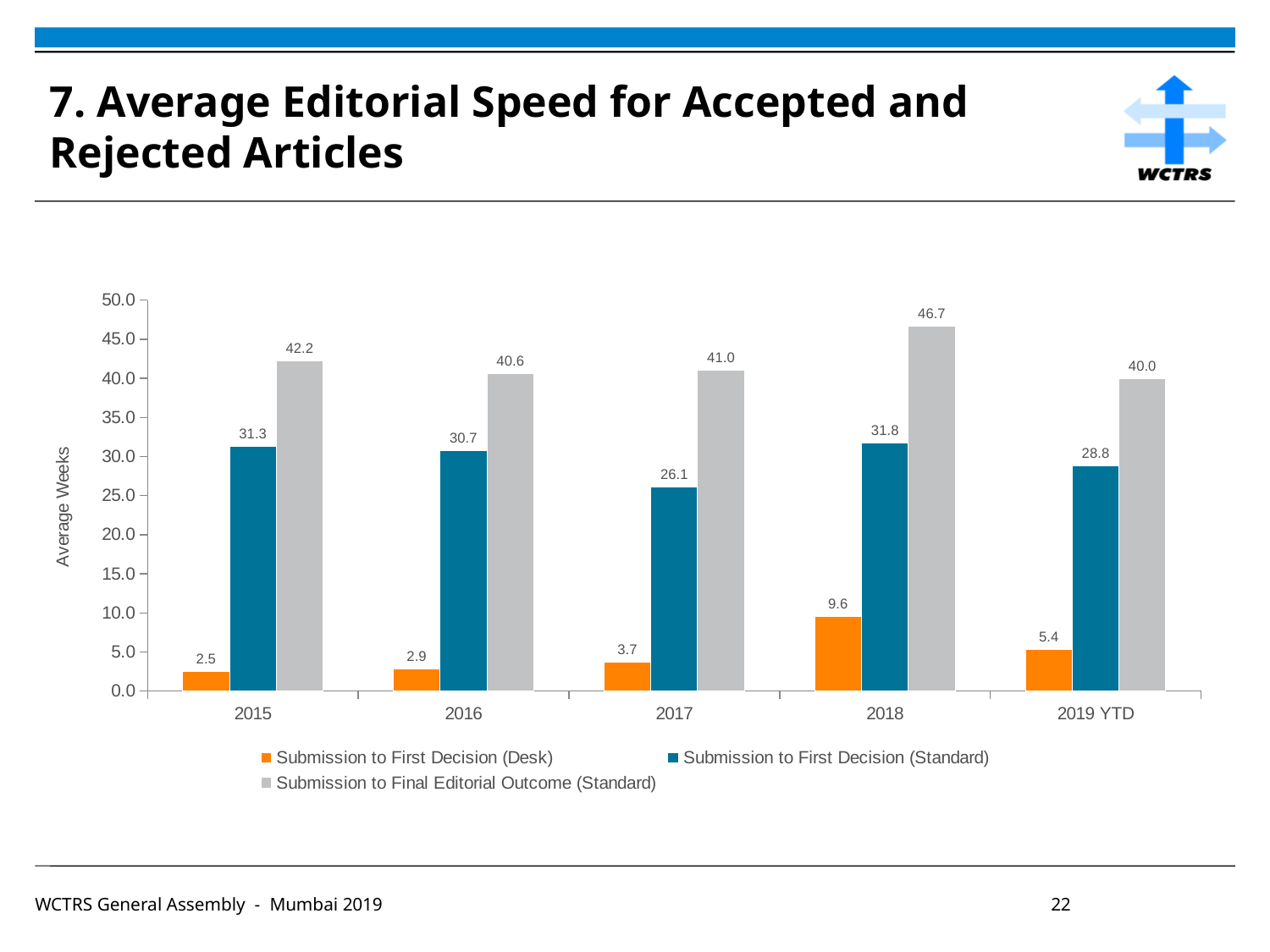
What kind of chart is shown on the slide? Bar chart Is the value for Submission to Final Editorial Outcome (Standard) in 2018 greater or less than 45.0? greater Which is larger: Submission to First Decision (Standard) in 2015 or in 2017? 2015 How many series does the legend list? 3 What is the difference between Submission to Final Editorial Outcome (Standard) and Submission to First Decision (Standard) in 2017? 14.9 In which year is Submission to Final Editorial Outcome (Standard) highest? 2018 In which year is Submission to First Decision (Desk) lowest? 2015 What is the value for Submission to First Decision (Desk) in 2018? 9.6 How many year categories are shown on the x axis? 5 What is the value for Submission to First Decision (Standard) in 2019 YTD? 28.8 What is the value for Submission to Final Editorial Outcome (Standard) in 2016? 40.6 What is the label of the y axis? Average Weeks